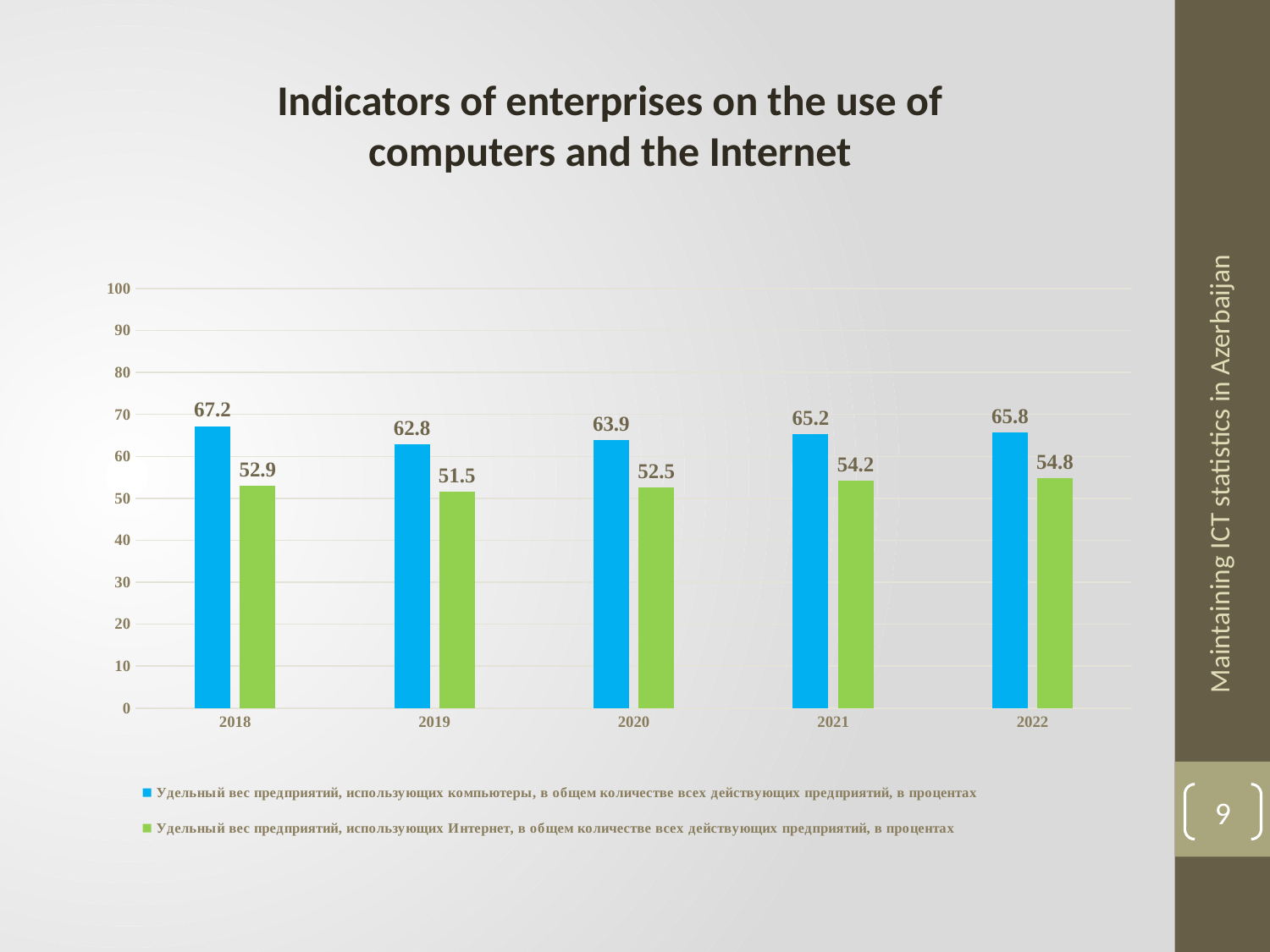
What is the difference between the blue and green values in 2022? 11 What is the value of the blue series (enterprises using computers) for 2018? 67.2 In which year is the green series (enterprises using the Internet) lowest? 2019 In which year is the blue series (enterprises using computers) highest? 2018 Which is larger in 2020: the blue series value or the green series value? The blue series (63.9) Is the green series value for 2018 greater or less than 60? less What is the value of the blue series (enterprises using computers) for 2020? 63.9 How many series does the legend list? 2 What kind of chart is shown on the slide? Bar chart How many years are shown on the x axis? 5 What is the difference between the blue series values for 2018 and 2019? 4.4 What is the value of the green series (enterprises using the Internet) for 2021? 54.2